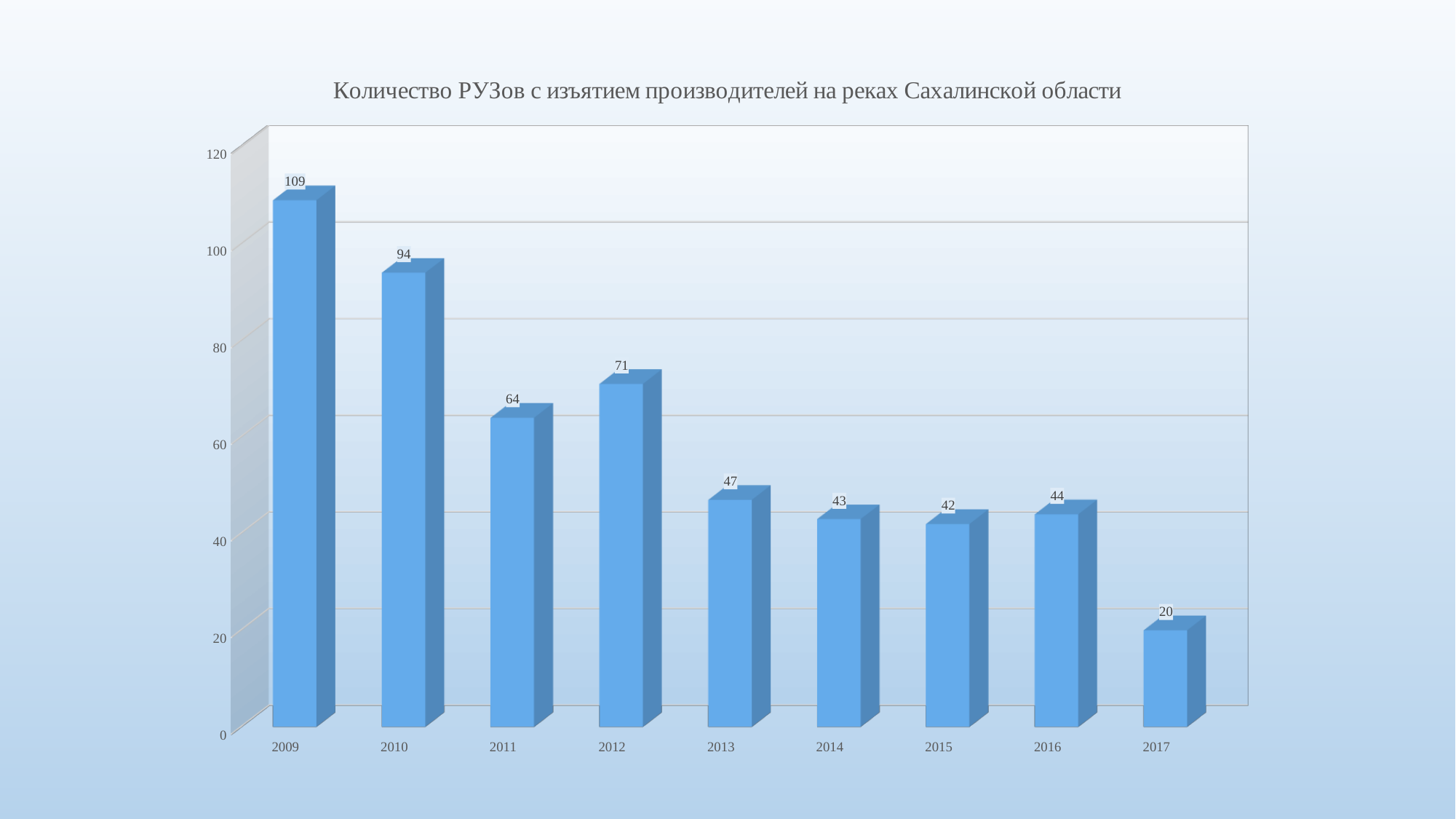
What is the difference between the values for 2009 and 2010? 15 What is the value for 2017? 20 What is the value for 2012? 71 Which year has the lowest value? 2017 Is the value for 2010 greater or less than 80? greater What kind of chart is shown on the slide? bar chart Which is larger, the value for 2011 or the value for 2012? 2012 What is the title of the chart? Количество РУЗов с изъятием производителей на реках Сахалинской области What is the difference between the values for 2011 and 2017? 44 How many years are shown on the x axis? 9 Which year has the highest value? 2009 What is the value for 2009? 109